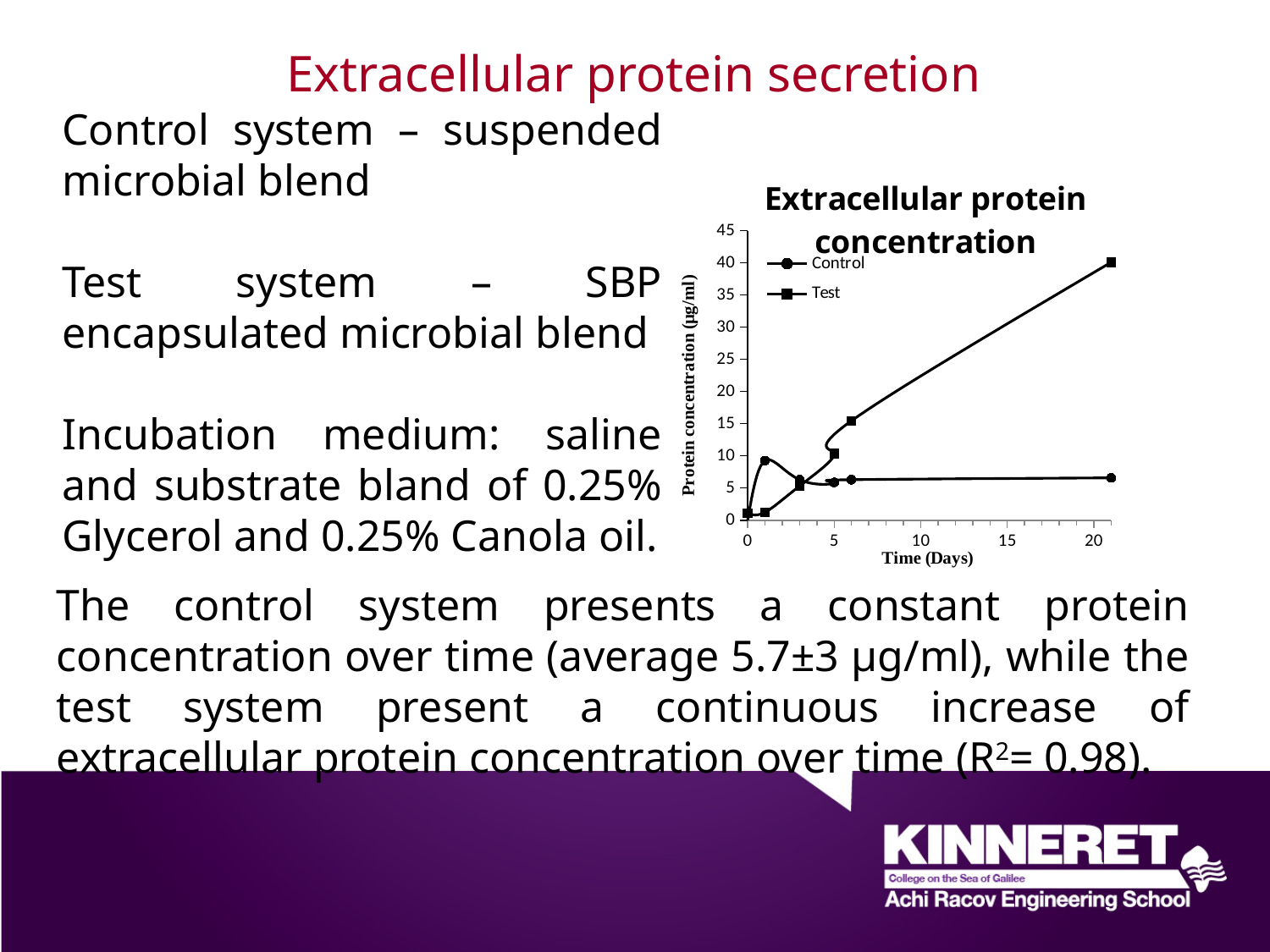
Is the value for the Control series at about day 1 greater or less than 5? greater How many series does the chart legend list? 2 What are the two series named in the chart legend? Control and Test Do the values of the Test series rise or fall as time increases along the x axis? rise What kind of chart is shown on the slide? line chart Is the value for the Test series at the last time point (around day 21) greater or less than 35? greater Is the value for the Test series at about day 6 greater or less than 10? greater Which series reaches the highest protein concentration in the chart? Test At the last time point (around day 21), which series has the larger value, Control or Test? Test What is the title of the chart? Extracellular protein concentration